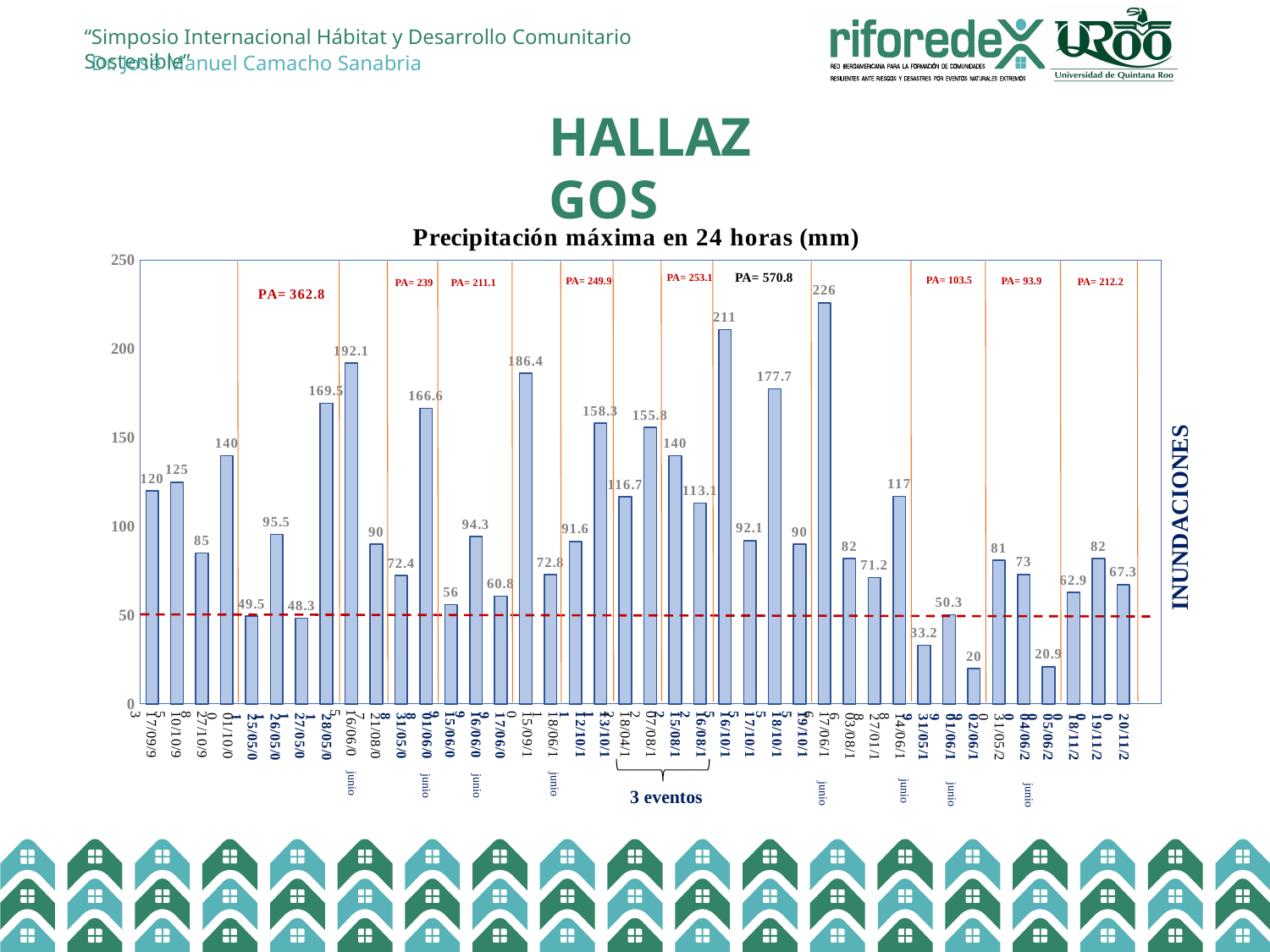
What is the difference between the two tallest bars, 226 and 211? 15 What is the value of the last (rightmost) bar in the chart? 67.3 How many bars are plotted in the chart? 40 Is the value of the bar labelled 33.2 greater or less than 50? less What is the value of the first (leftmost) bar in the chart? 120 What is the title of the chart? Precipitación máxima en 24 horas (mm) What is the lowest value shown in the chart? 20 What is the PA value annotated in the first section of the chart, above the bars on the left? PA= 362.8 Which is larger, the bar labelled 186.4 or the bar labelled 177.7? 186.4 What type of chart is shown on the slide? bar chart What is the highest value shown in the chart? 226 What is the difference between the bars labelled 192.1 and 169.5? 22.6